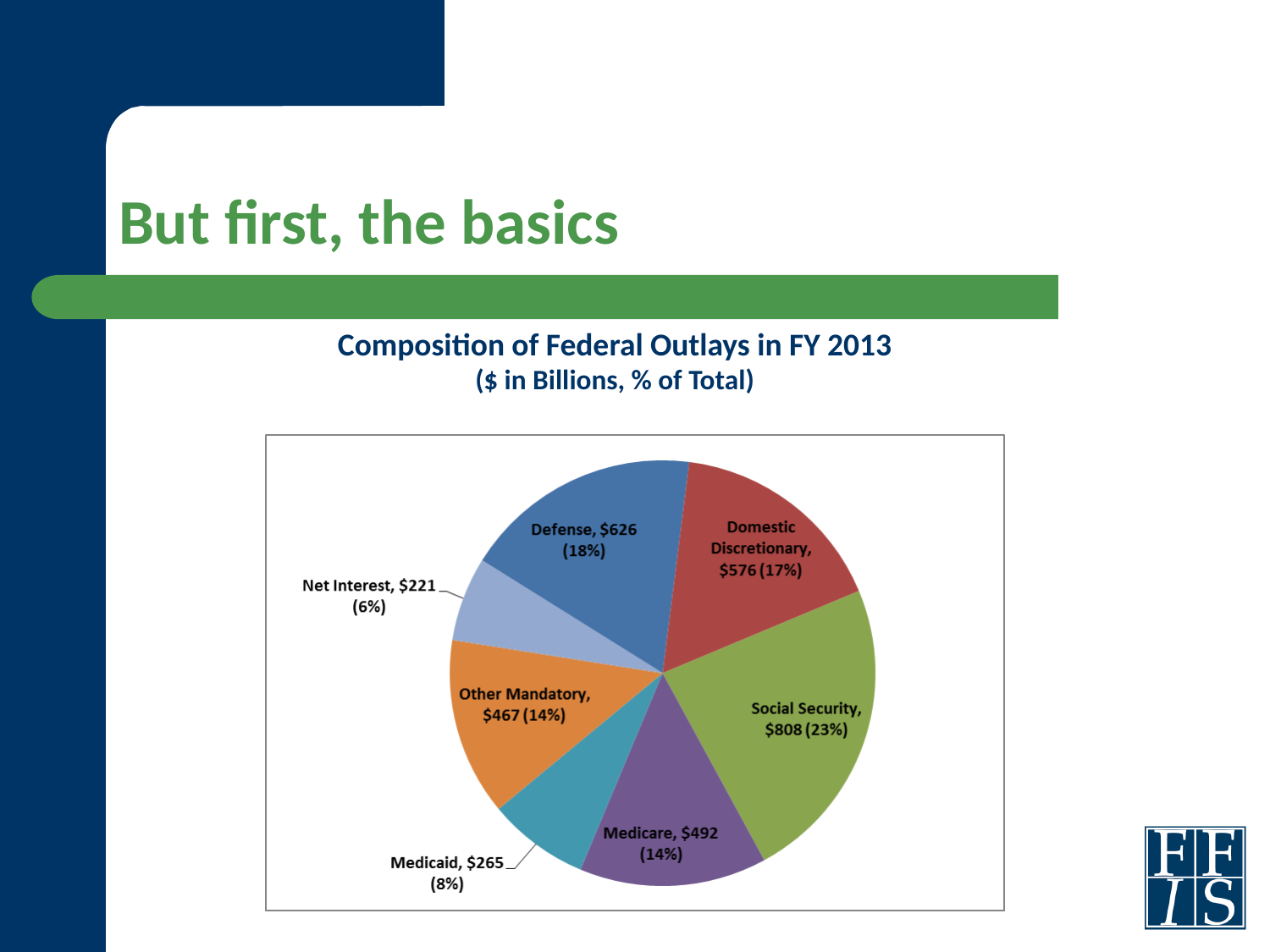
Which is larger, Defense or Domestic Discretionary? Defense What type of chart is shown on the slide? Pie chart What share of total outlays is Other Mandatory? 14% What percentage of total outlays is Net Interest? 6% What is the dollar value for Defense? $626 What is the dollar value for Medicaid? $265 What is the title of the chart? Composition of Federal Outlays in FY 2013 What is the difference in dollars between Social Security and Medicare? $316 Which category has the smallest share of federal outlays? Net Interest How many categories are shown in the pie chart? 7 Which category has the largest share of federal outlays? Social Security What is the value for Social Security in the pie chart? $808 (23%)